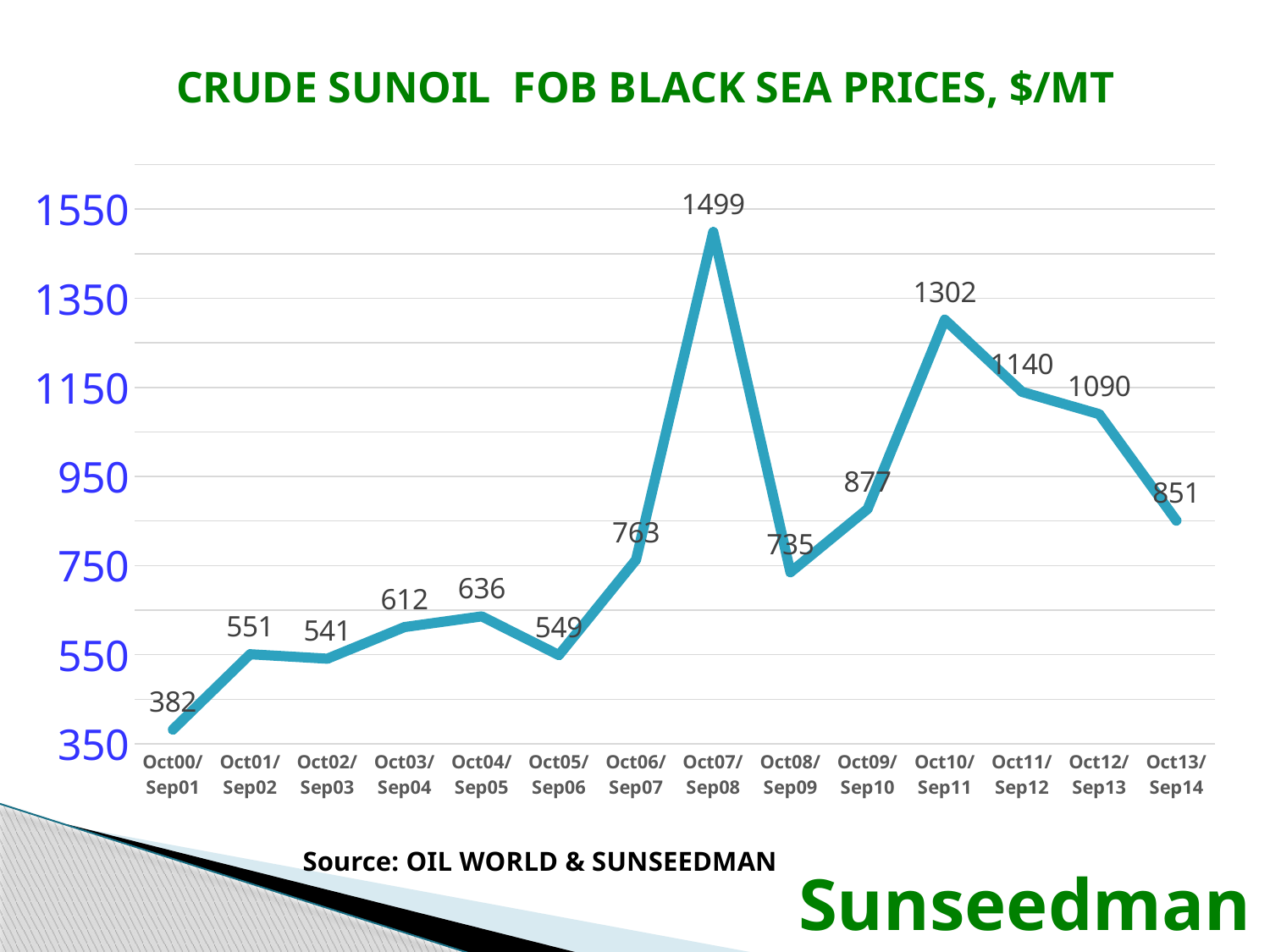
What kind of chart is shown on the slide? line chart What is the crude sunoil FOB Black Sea price for Oct07/Sep08? 1499 Does the price rise or fall from Oct10/Sep11 to Oct13/Sep14? fall What is the title of the chart? CRUDE SUNOIL FOB BLACK SEA PRICES, $/MT What is the price shown for Oct13/Sep14? 851 What is the price shown for Oct00/Sep01? 382 How many periods are plotted on the x axis? 14 Which is larger, the price for Oct10/Sep11 or the price for Oct11/Sep12? Oct10/Sep11 Which period has the lowest price? Oct00/Sep01 Which period has the highest price? Oct07/Sep08 What is the difference between the prices for Oct07/Sep08 and Oct08/Sep09? 764 Is the price for Oct09/Sep10 greater or less than 950? less